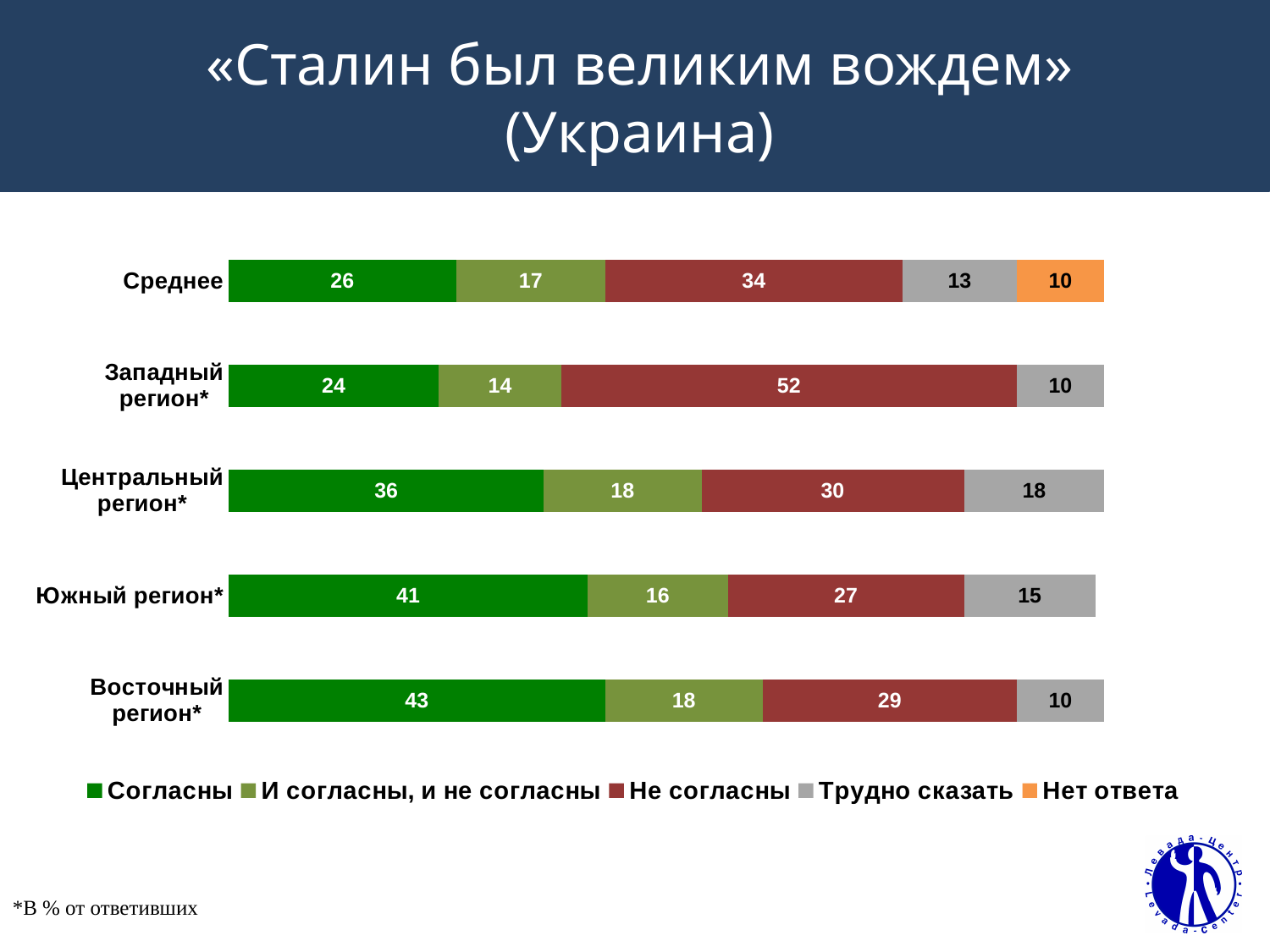
Which is larger: the "Согласны" value for Южный регион* or for Центральный регион*? Южный регион* What is the value for "Трудно сказать" in the Центральный регион* bar? 18 What is the total of the Центральный регион* stacked bar? 102 What is the value for "Согласны" in the Восточный регион* bar? 43 What is the value for "Нет ответа" in the Среднее bar? 10 What is the difference between the "Не согласны" values for Западный регион* and Южный регион*? 25 How many categories (bars) are shown in the chart? 5 What kind of chart is shown on the slide? Stacked bar chart Which category has the lowest value for "Согласны"? Западный регион* Which category has the highest value for "Согласны"? Восточный регион* How many series does the legend list? 5 What is the value for "Не согласны" in the Западный регион* bar? 52